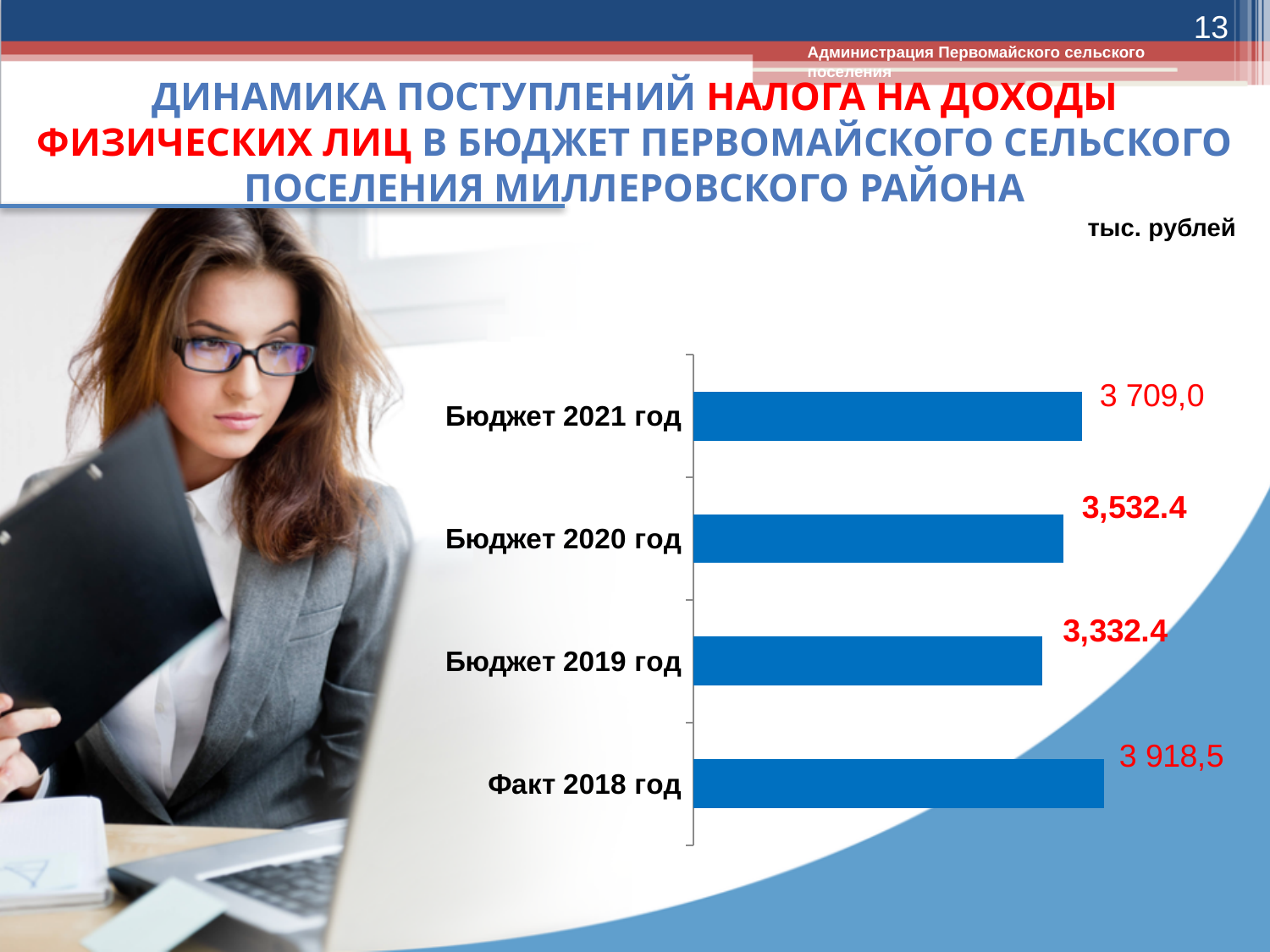
Do the budget values rise or fall from Бюджет 2019 год to Бюджет 2021 год? Rise What is the difference between the values for Бюджет 2020 год and Бюджет 2019 год? 200.0 What is the value for Бюджет 2020 год? 3,532.4 Which category has the highest value? Факт 2018 год What kind of chart is shown on the slide? Bar chart How many categories are shown in the chart? 4 In what units are the chart values given? тыс. рублей What is the value for Бюджет 2019 год? 3,332.4 Which category has the lowest value? Бюджет 2019 год What is the value for Бюджет 2021 год? 3 709,0 What is the value for Факт 2018 год? 3 918,5 Which is larger, the value for Бюджет 2021 год or the value for Бюджет 2020 год? Бюджет 2021 год